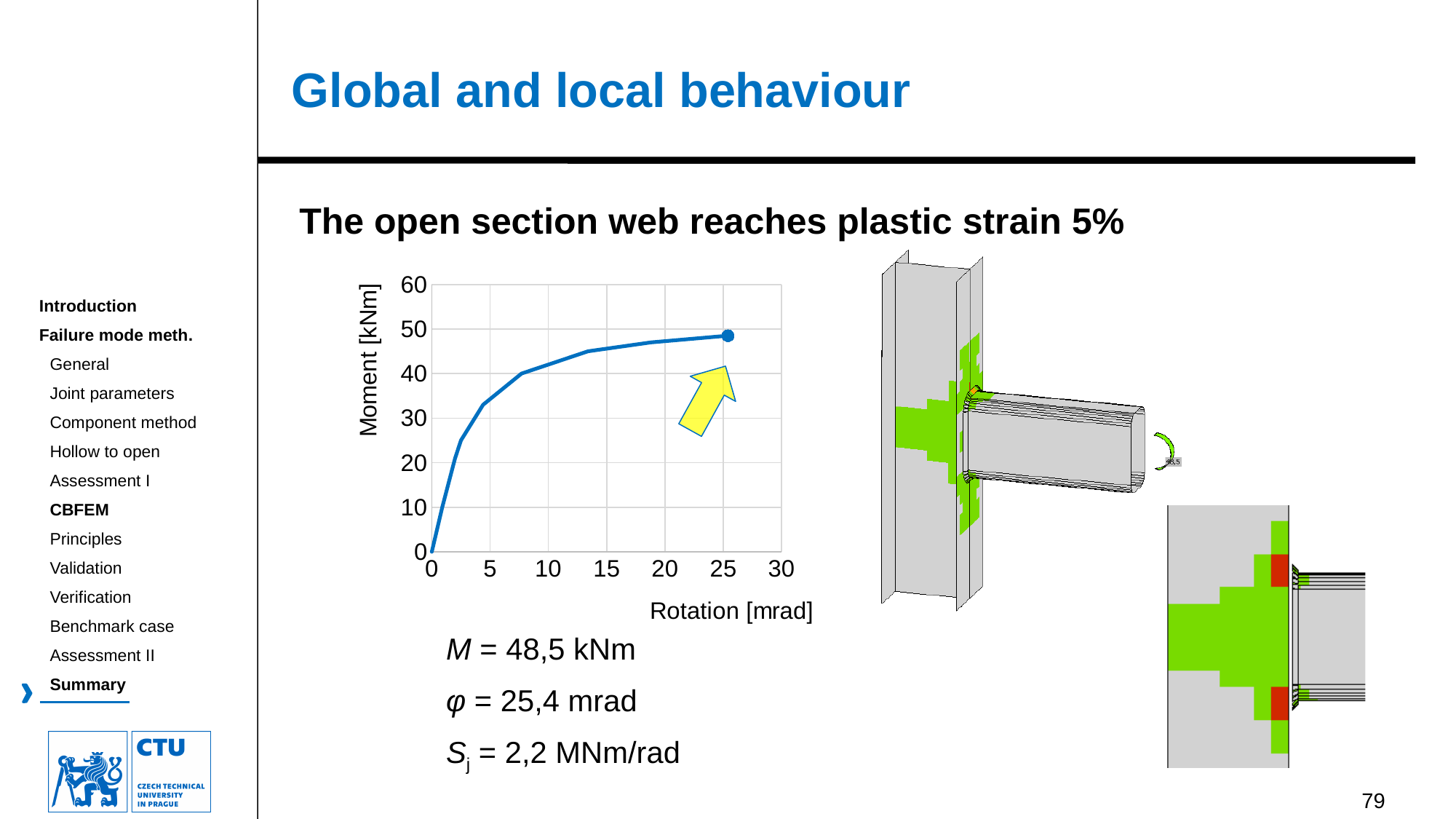
What is the label of the x axis of the chart? Rotation [mrad] Is the moment at a rotation of 5 mrad greater or less than 30? greater Is the moment at a rotation of 20 mrad greater or less than 40? greater How many curves are plotted on the chart? 1 What is the moment at the final marked point of the curve? 48,5 kNm Does the moment rise or fall as rotation increases along the x axis? rises What is the highest value shown on the y axis of the chart? 60 What is the rotation at the final marked point of the curve? 25,4 mrad What kind of chart is shown on the slide? line chart What is the label of the y axis of the chart? Moment [kNm] Is the moment at the final marked point greater or less than 50? less